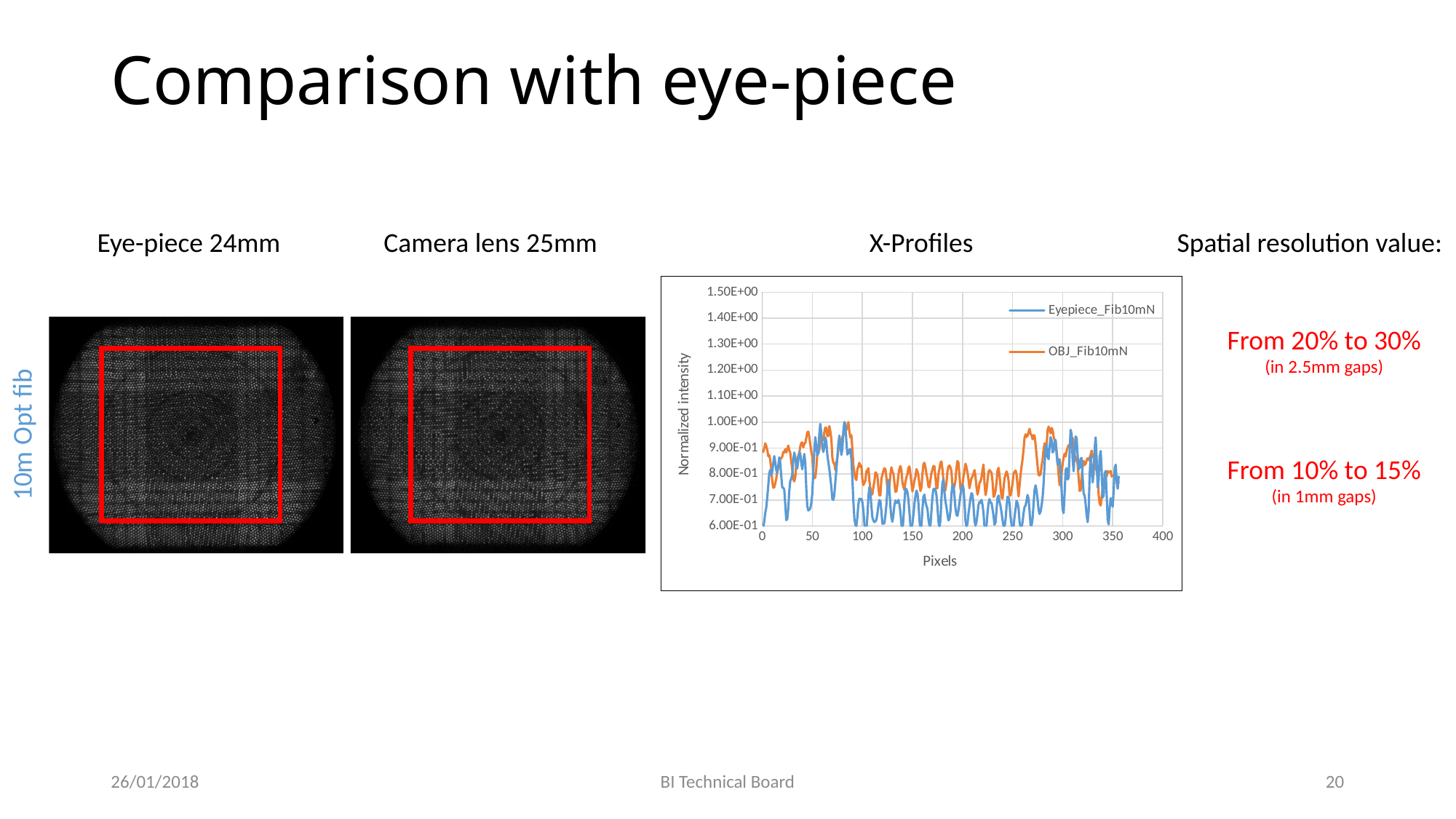
What is the label of the x axis of the X-Profiles chart? Pixels How many series does the legend of the X-Profiles chart list? 2 In the X-Profiles chart, is the value for Eyepiece_Fib10mN at pixel 0 greater or less than 7.00E-01? less What kind of chart is the X-Profiles chart? line chart In the X-Profiles chart, is the highest value reached by OBJ_Fib10mN greater or less than 1.20E+00? less What are the two series named in the legend of the X-Profiles chart? Eyepiece_Fib10mN and OBJ_Fib10mN In the X-Profiles chart, is the value for OBJ_Fib10mN at pixel 0 greater or less than 8.00E-01? greater In the X-Profiles chart, between pixels 100 and 250, which series generally has the higher values, Eyepiece_Fib10mN or OBJ_Fib10mN? OBJ_Fib10mN